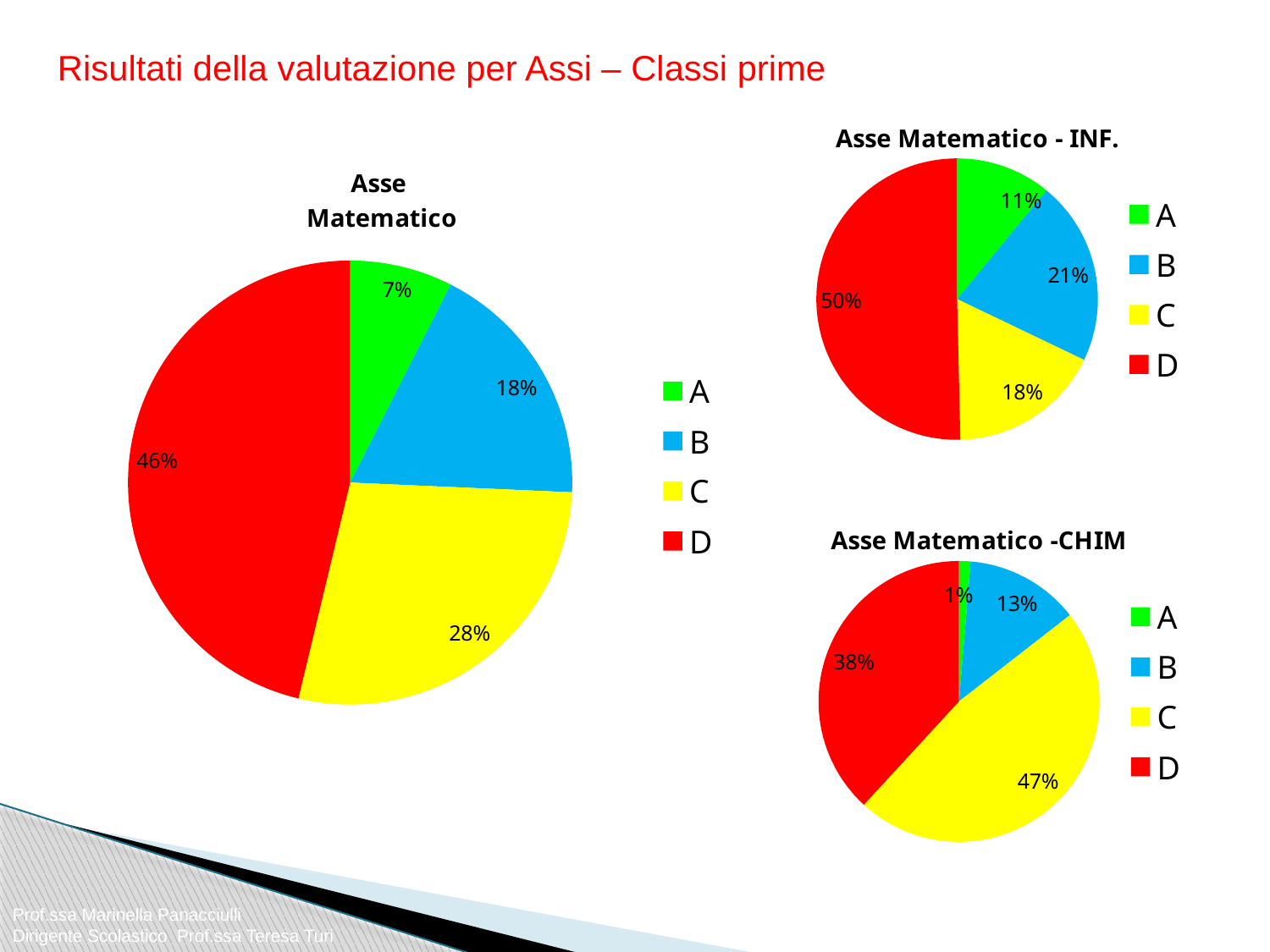
In the 'Asse Matematico - INF.' chart, what is the value for category B? 21% In the 'Asse Matematico' chart, which category has the smallest slice? A What type of chart is the 'Asse Matematico - INF.' chart? Pie chart In the 'Asse Matematico' chart, what is the share for category D? 46% In the 'Asse Matematico' chart, what is the difference between the shares of D and C? 18% In the 'Asse Matematico - INF.' chart, which is larger, the slice for B or the slice for C? B How many categories does the legend of the 'Asse Matematico -CHIM' chart list? 4 In the 'Asse Matematico -CHIM' chart, what is the value for category A? 1% In the 'Asse Matematico' chart, what is the value for category C? 28% In the 'Asse Matematico -CHIM' chart, which category has the largest slice? C In the 'Asse Matematico - INF.' chart, what is the share for category D? 50% In the 'Asse Matematico -CHIM' chart, what is the difference between the shares of C and D? 9%